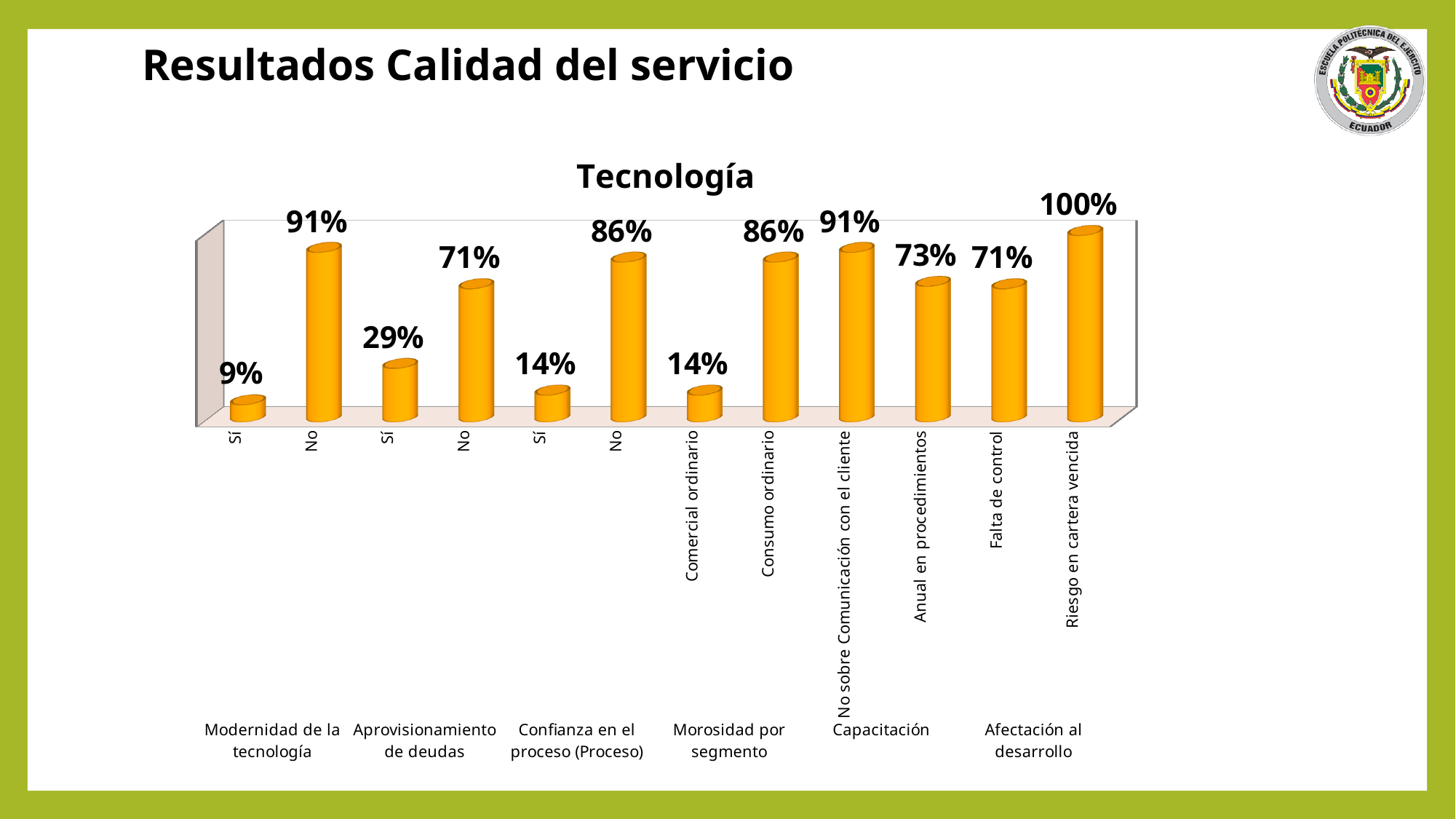
Which bar has the lowest value in the chart? Sí (Modernidad de la tecnología) Which is larger: 'Falta de control' or 'Riesgo en cartera vencida' under 'Afectación al desarrollo'? Riesgo en cartera vencida What is the value for 'Consumo ordinario' under 'Morosidad por segmento'? 86% What is the value for 'Sí' under 'Modernidad de la tecnología'? 9% What is the value for 'Anual en procedimientos' under 'Capacitación'? 73% What kind of chart is shown on the slide? bar chart What is the difference between 'No' and 'Sí' under 'Confianza en el proceso (Proceso)'? 72% What is the difference between 'No sobre Comunicación con el cliente' and 'Anual en procedimientos' under 'Capacitación'? 18% Which bar has the highest value in the chart? Riesgo en cartera vencida How many bars are plotted in the chart? 12 What is the value for 'No' under 'Aprovisionamiento de deudas'? 71% What is the title of the chart? Tecnología